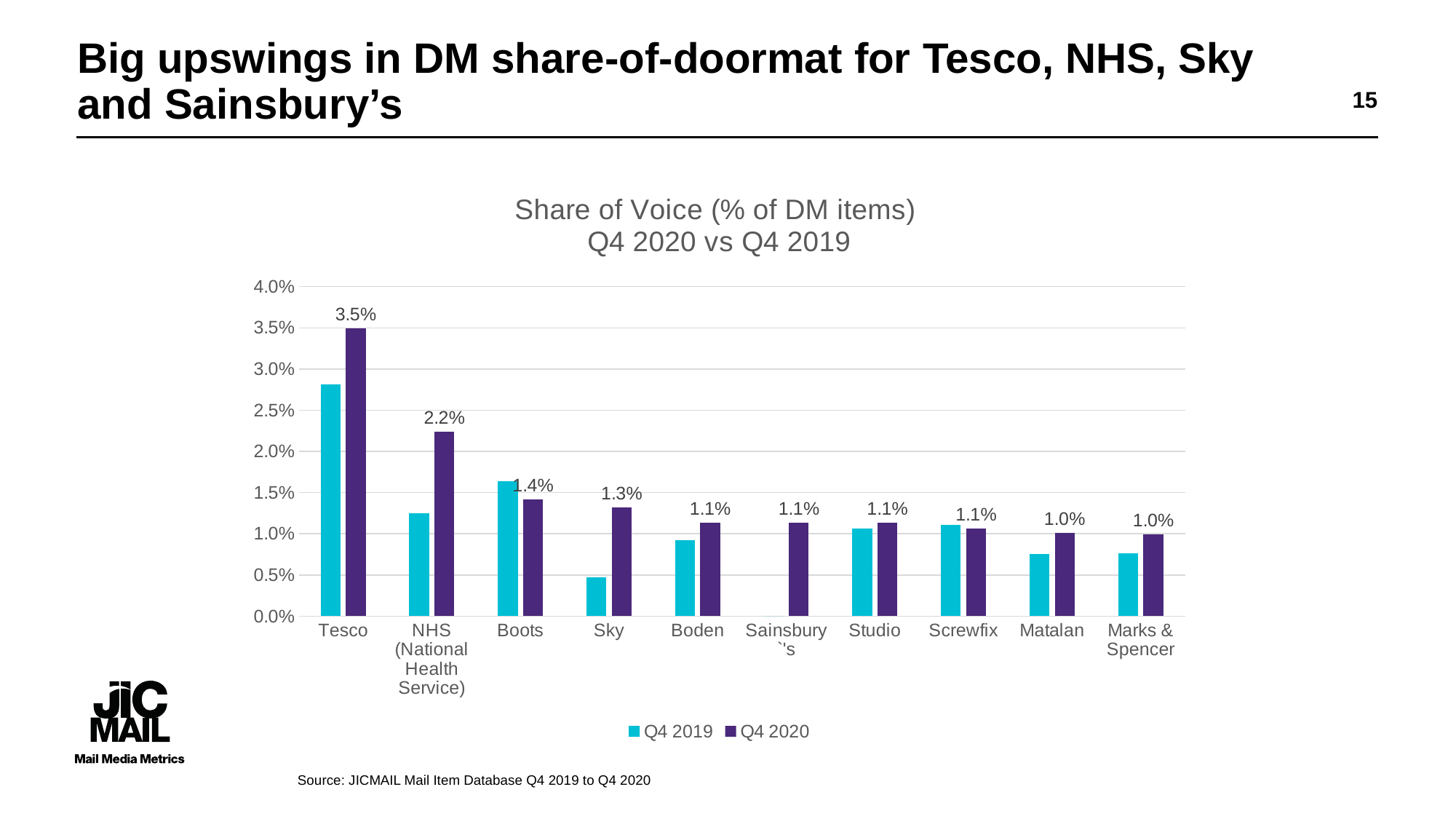
How many series does the legend list? 2 Which brand has the lowest Q4 2019 share of voice? Sainsbury's How many brands are shown on the x axis of the chart? 10 Is the Q4 2019 value for Sky greater or less than 1.0%? less What is the difference between the Q4 2020 share of voice for Tesco and for NHS (National Health Service)? 1.3% Which brand has the highest Q4 2020 share of voice? Tesco Is the Q4 2019 value for Tesco greater or less than 2.5%? greater What is the Q4 2020 share of voice for NHS (National Health Service)? 2.2% For Sky, which is larger: the Q4 2019 value or the Q4 2020 value? Q4 2020 What is the Q4 2020 share of voice for Tesco? 3.5% For Boots, which is larger: the Q4 2019 value or the Q4 2020 value? Q4 2019 What is the Q4 2020 share of voice for Sky? 1.3%